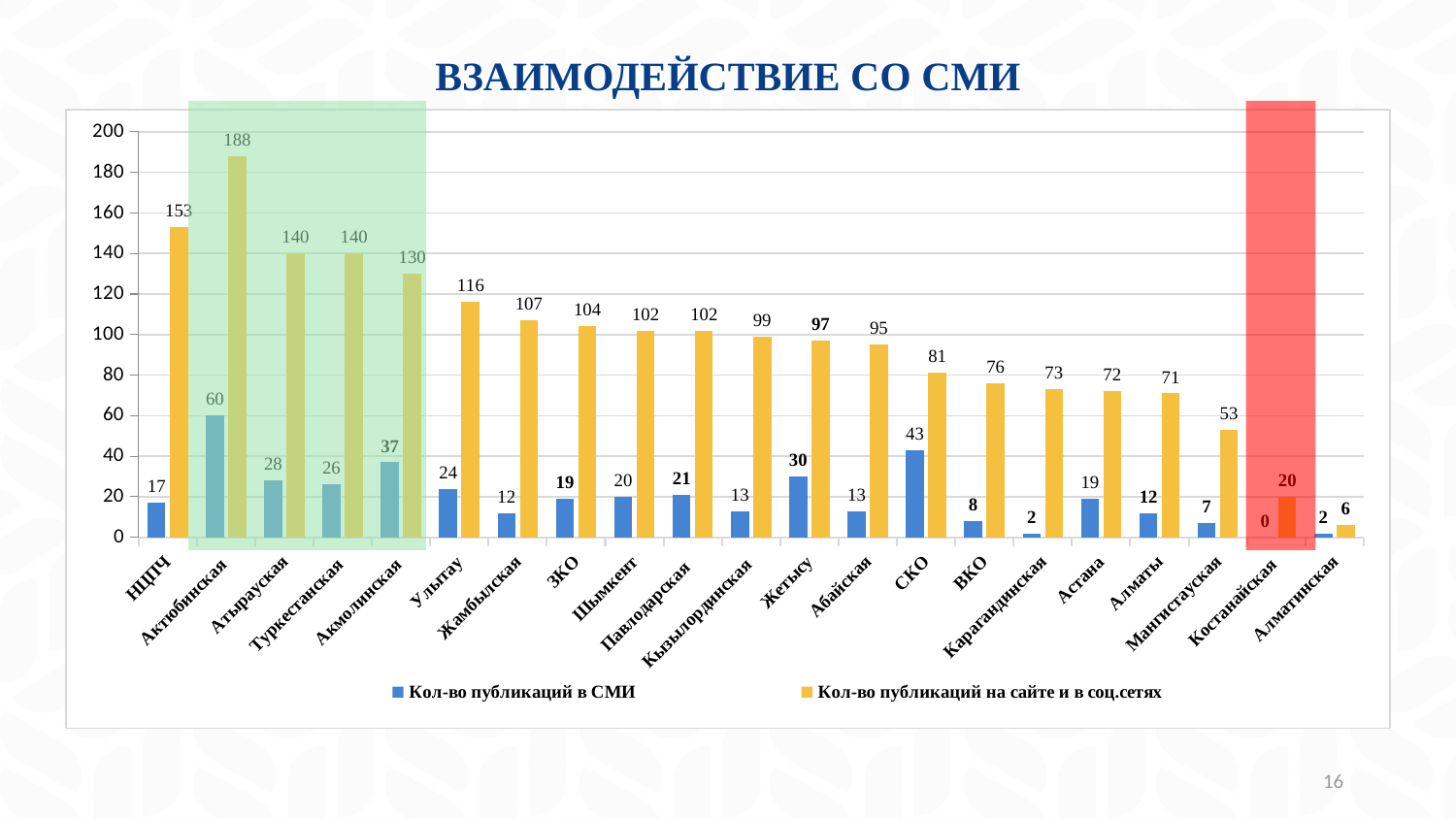
What kind of chart is shown on the slide? Bar chart What is the number of publications in the media (Кол-во публикаций в СМИ) for СКО? 43 What is the difference between the two series for Актюбинская (188 and 60)? 128 Is the value of Кол-во публикаций на сайте и в соц.сетях for Мангистауская greater or less than 60? less What is the number of publications on the website and social networks (Кол-во публикаций на сайте и в соц.сетях) for Актюбинская? 188 How many categories are shown on the x axis of the chart? 21 Which category has the highest value for Кол-во публикаций на сайте и в соц.сетях? Актюбинская How many series does the legend list? 2 Which category has the lowest value for Кол-во публикаций в СМИ? Костанайская What is the title of the slide containing the chart? ВЗАИМОДЕЙСТВИЕ СО СМИ Which category has the lowest value for Кол-во публикаций на сайте и в соц.сетях? Алматинская Which is larger: Кол-во публикаций на сайте и в соц.сетях for НЦПЧ or for Улытау? НЦПЧ